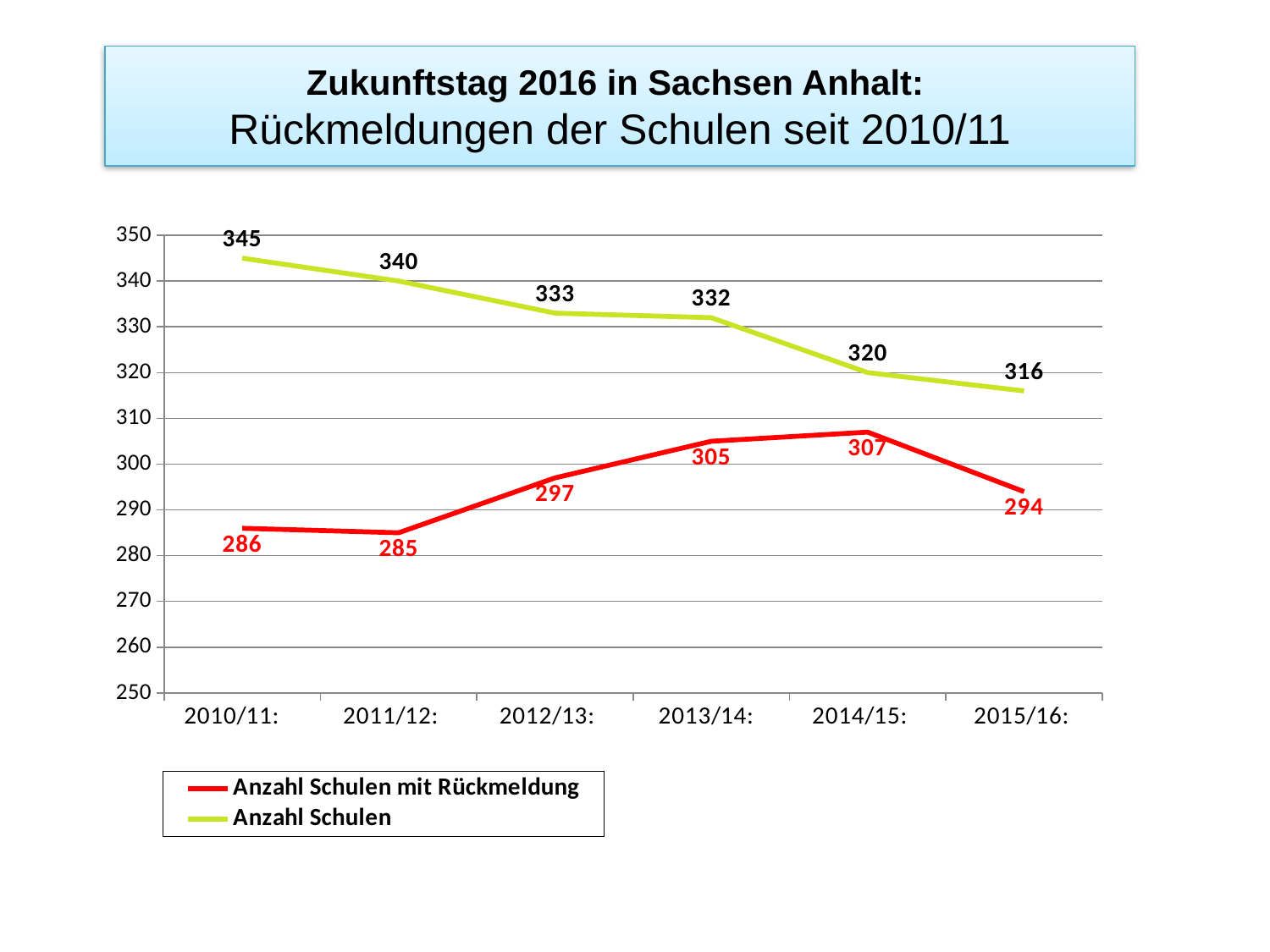
What is the value of Anzahl Schulen mit Rückmeldung for 2014/15? 307 What kind of chart is shown on the slide? line chart How many years are shown on the x axis? 6 Which is larger: Anzahl Schulen mit Rückmeldung in 2012/13 or in 2013/14? 2013/14 How many series does the legend list? 2 Does Anzahl Schulen rise or fall from 2010/11 to 2015/16? fall In which year is Anzahl Schulen highest? 2010/11 What is the value of Anzahl Schulen mit Rückmeldung for 2015/16? 294 In which year is Anzahl Schulen mit Rückmeldung lowest? 2011/12 What is the difference between Anzahl Schulen in 2010/11 and in 2015/16? 29 What is the value of Anzahl Schulen for 2010/11? 345 What is the difference between Anzahl Schulen and Anzahl Schulen mit Rückmeldung in 2015/16? 22